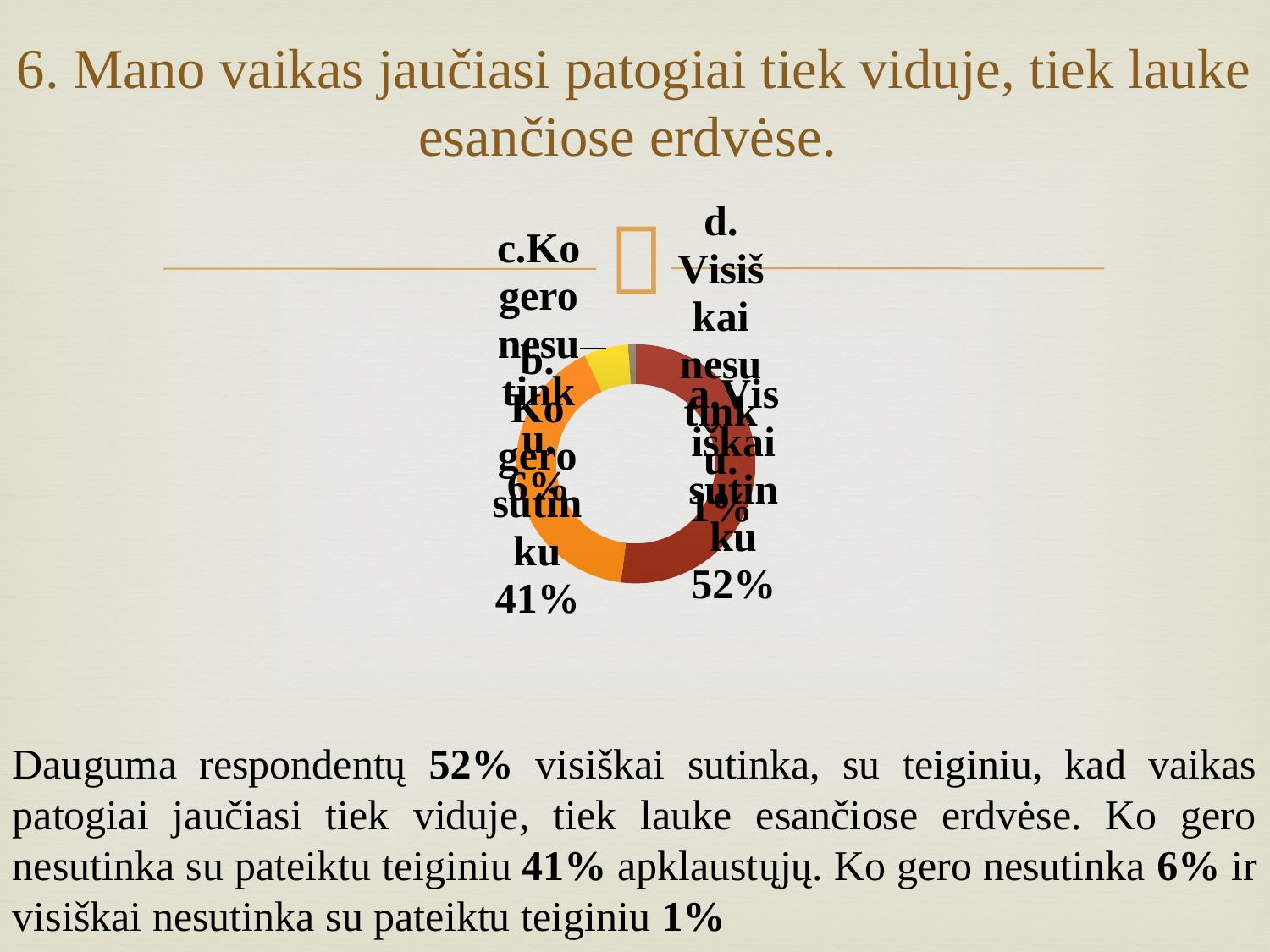
Which answer option has the largest share in the chart? a. Visiškai sutinku What share of respondents answered "b. Ko gero sutinku"? 41% What share of respondents answered "c. Ko gero nesutinku"? 6% What is the difference in percentage points between "a. Visiškai sutinku" and "b. Ko gero sutinku"? 11 percentage points What share of respondents answered "d. Visiškai nesutinku"? 1% Which answer option has the smallest share in the chart? d. Visiškai nesutinku What colour is the slice for "a. Visiškai sutinku"? Dark red What kind of chart is shown on the slide? Doughnut (pie) chart What share of respondents answered "a. Visiškai sutinku"? 52% Which is larger: the share for "c. Ko gero nesutinku" or for "d. Visiškai nesutinku"? c. Ko gero nesutinku What is the combined share of "a. Visiškai sutinku" and "b. Ko gero sutinku"? 93% How many answer categories are shown in the chart? 4